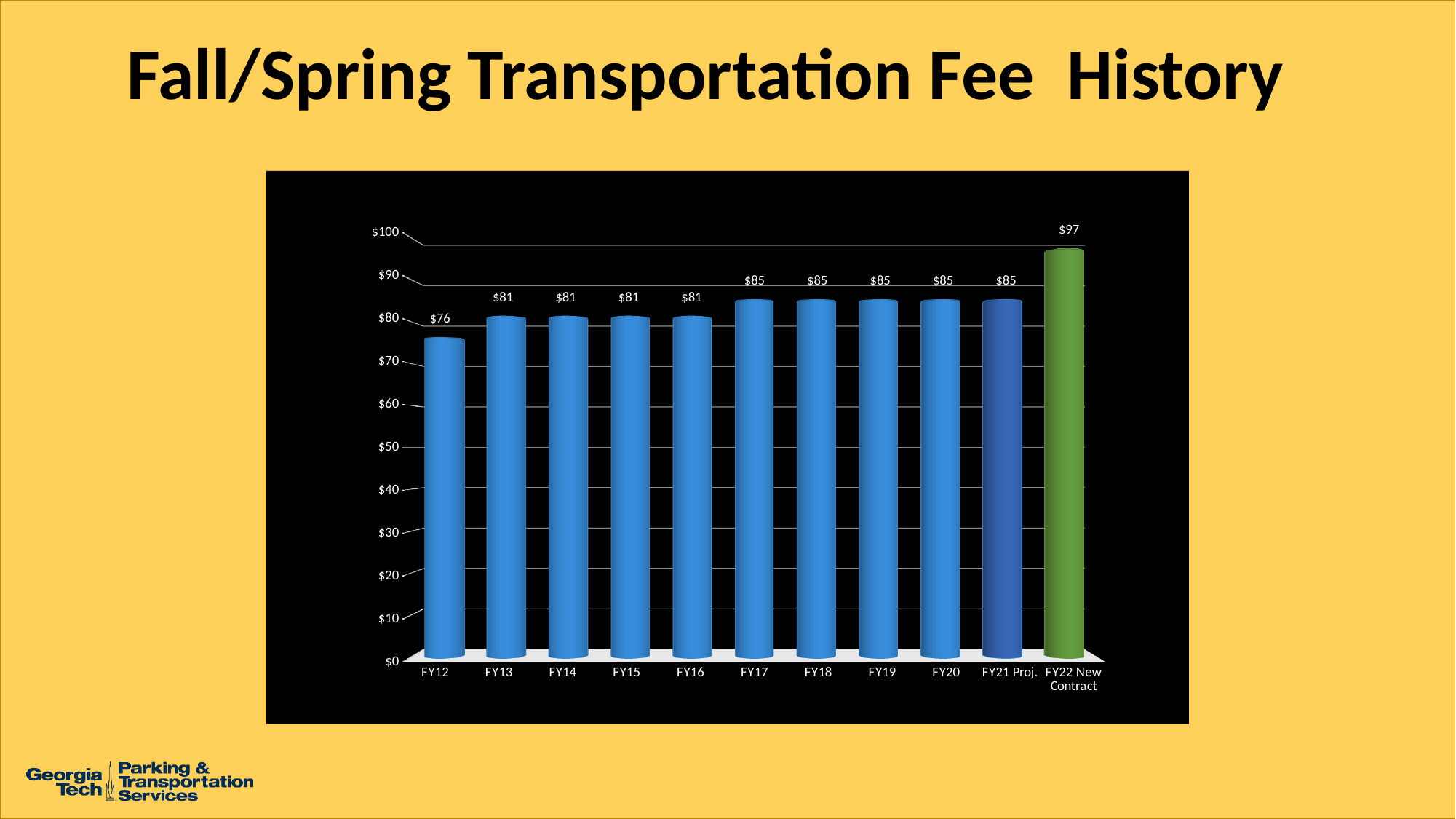
What is the transportation fee for FY22 New Contract? $97 What is the transportation fee for FY14? $81 What kind of chart is shown on the slide? Bar chart What is the transportation fee for FY12? $76 What is the transportation fee for FY21 Proj.? $85 Which is larger, the fee for FY16 or the fee for FY17? FY17 Which category has the lowest fee? FY12 What is the difference between the FY22 New Contract fee and the FY21 Proj. fee? $12 What is the difference between the FY13 fee and the FY12 fee? $5 Do the fee values generally rise or fall from FY12 to FY22 New Contract? Rise Which category has the highest fee? FY22 New Contract How many categories are shown on the x axis? 11